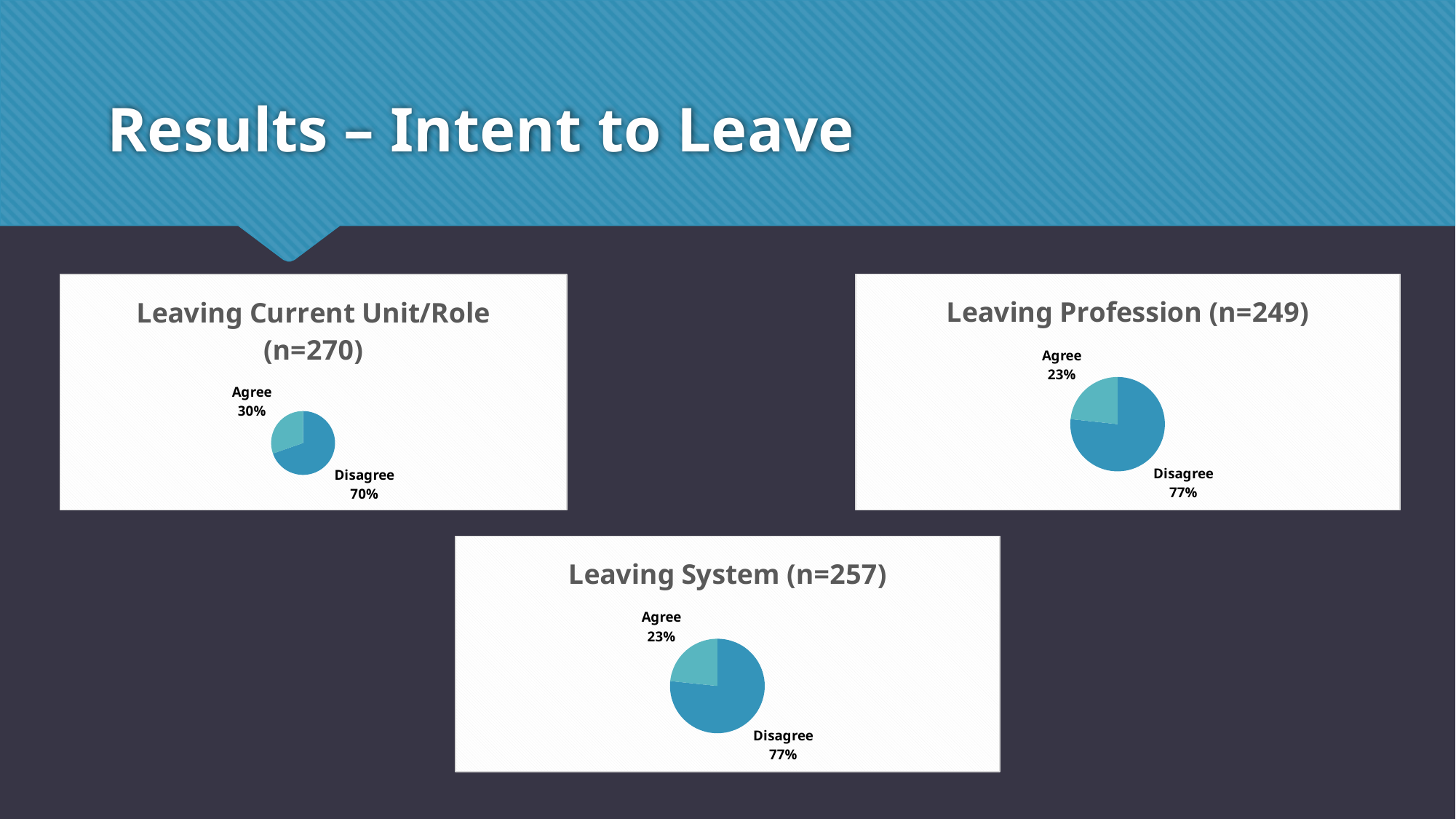
How many slices does the 'Leaving System (n=257)' pie chart have? 2 In the 'Leaving Current Unit/Role (n=270)' chart, what percentage of respondents Agree? 30% In the 'Leaving Profession (n=249)' chart, what percentage of respondents Disagree? 77% In the 'Leaving System (n=257)' chart, what percentage of respondents Agree? 23% In the 'Leaving Profession (n=249)' chart, what percentage of respondents Agree? 23% In the 'Leaving Current Unit/Role (n=270)' chart, what percentage of respondents Disagree? 70% In the 'Leaving System (n=257)' chart, what is the difference between the Disagree and Agree percentages? 54% In the 'Leaving System (n=257)' chart, what percentage of respondents Disagree? 77% How many pie charts are shown on the slide? 3 In the 'Leaving Current Unit/Role (n=270)' chart, which slice is larger, Agree or Disagree? Disagree In the 'Leaving Current Unit/Role (n=270)' chart, what is the difference between the Disagree and Agree percentages? 40% What kind of chart is used in the 'Leaving Profession (n=249)' panel? Pie chart